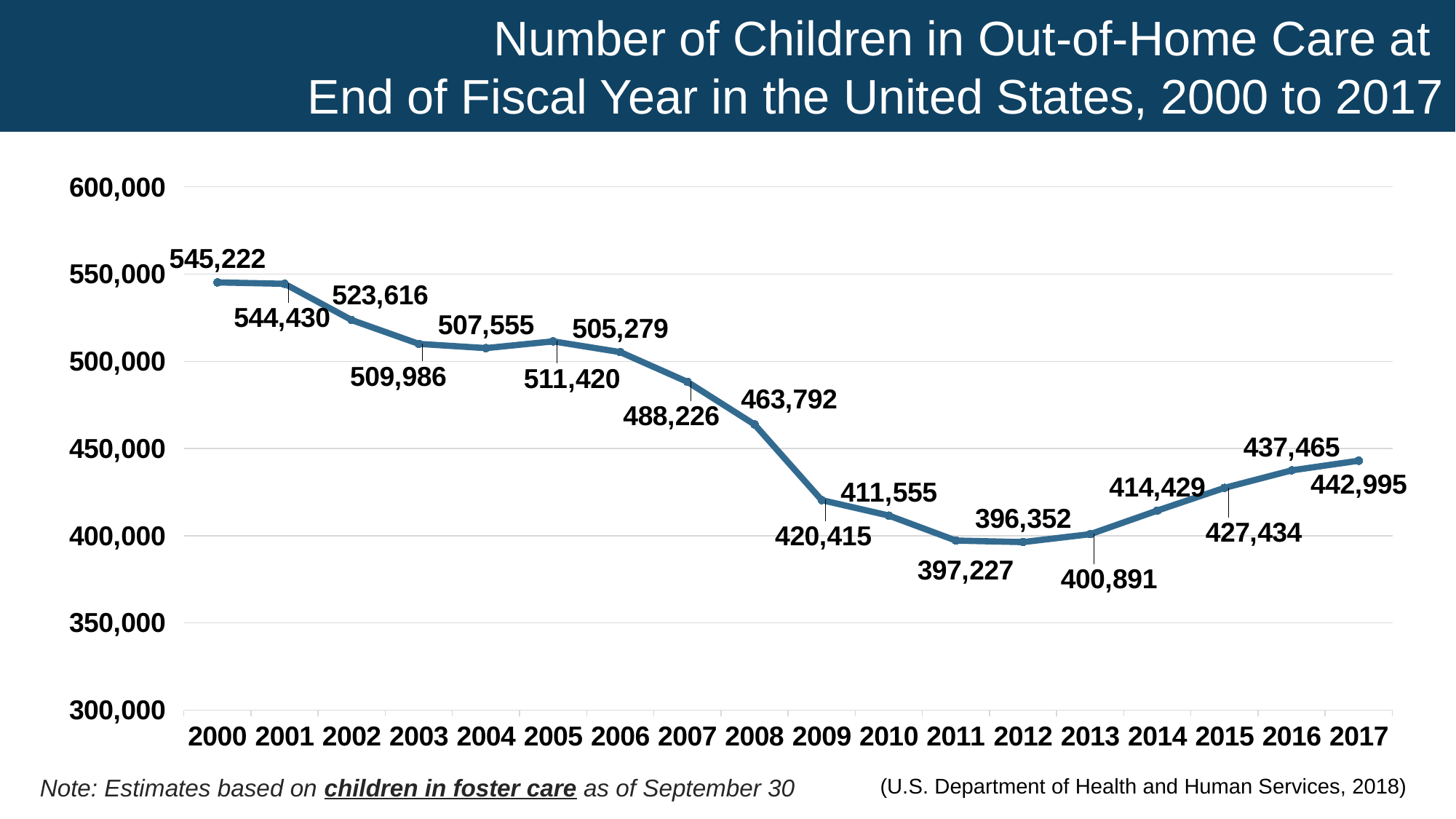
What is the difference between the number of children in out-of-home care in 2000 and in 2017? 102,227 Which year had the highest number of children in out-of-home care? 2000 What was the number of children in out-of-home care at the end of fiscal year 2012? 396,352 What type of chart is shown on the slide? line chart Which year had more children in out-of-home care, 2005 or 2014? 2005 Which year had the lowest number of children in out-of-home care? 2012 What was the number of children in out-of-home care at the end of fiscal year 2017? 442,995 What is the overall trend in the number of children in out-of-home care from 2000 to 2012? falling How many years are plotted on the chart? 18 What was the number of children in out-of-home care at the end of fiscal year 2000? 545,222 What was the number of children in out-of-home care at the end of fiscal year 2008? 463,792 What is the highest value shown on the vertical axis of the chart? 600,000